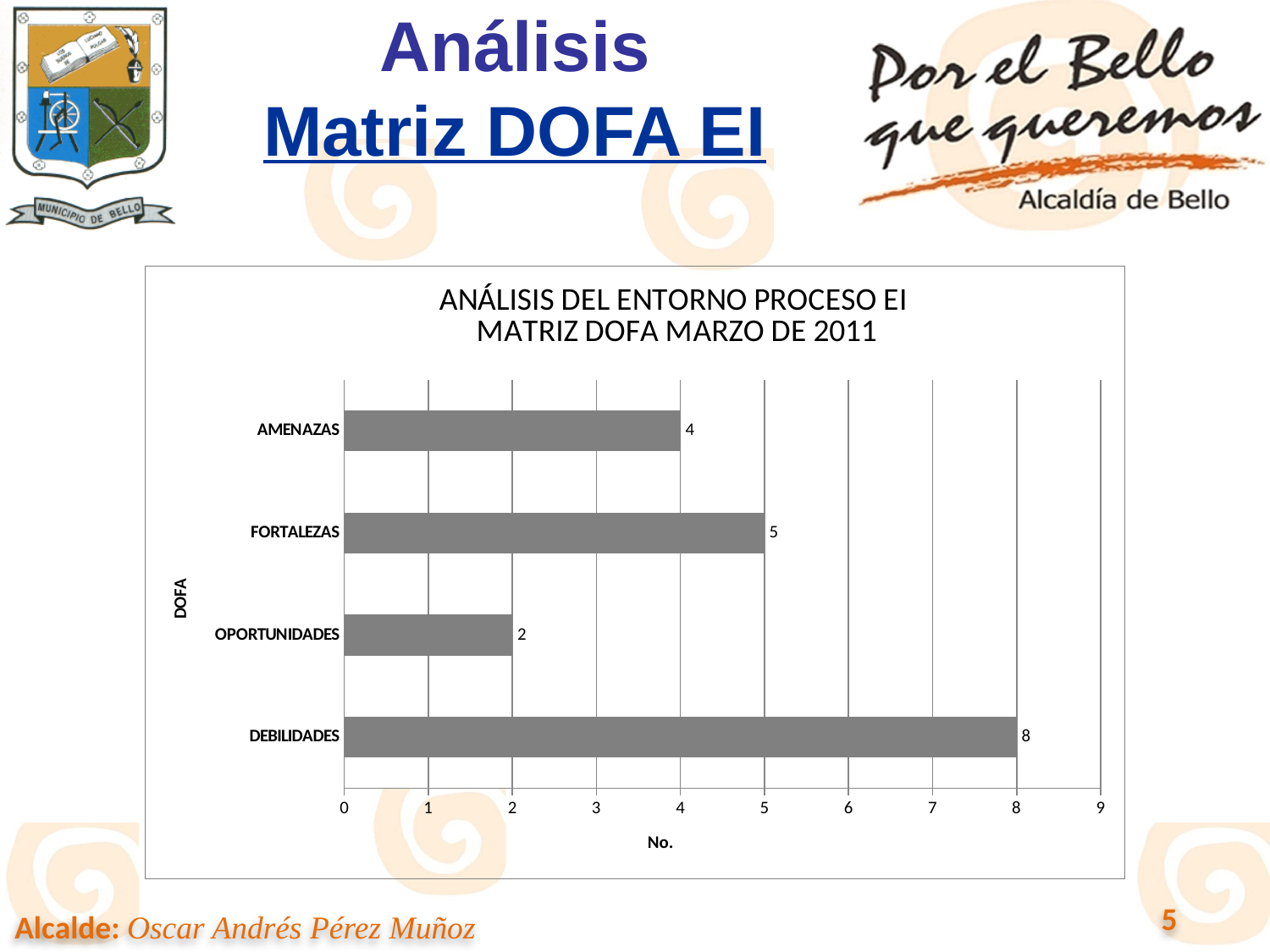
What is the label of the vertical axis? DOFA What kind of chart is shown on the slide? Bar chart What is the difference between the values for DEBILIDADES and FORTALEZAS? 3 What is the value for AMENAZAS? 4 What is the value for FORTALEZAS? 5 Which is larger, the value for FORTALEZAS or the value for AMENAZAS? FORTALEZAS What is the label of the horizontal axis? No. How many categories are shown on the chart? 4 What is the value for OPORTUNIDADES? 2 Which category has the highest value? DEBILIDADES Which category has the lowest value? OPORTUNIDADES What is the value for DEBILIDADES? 8